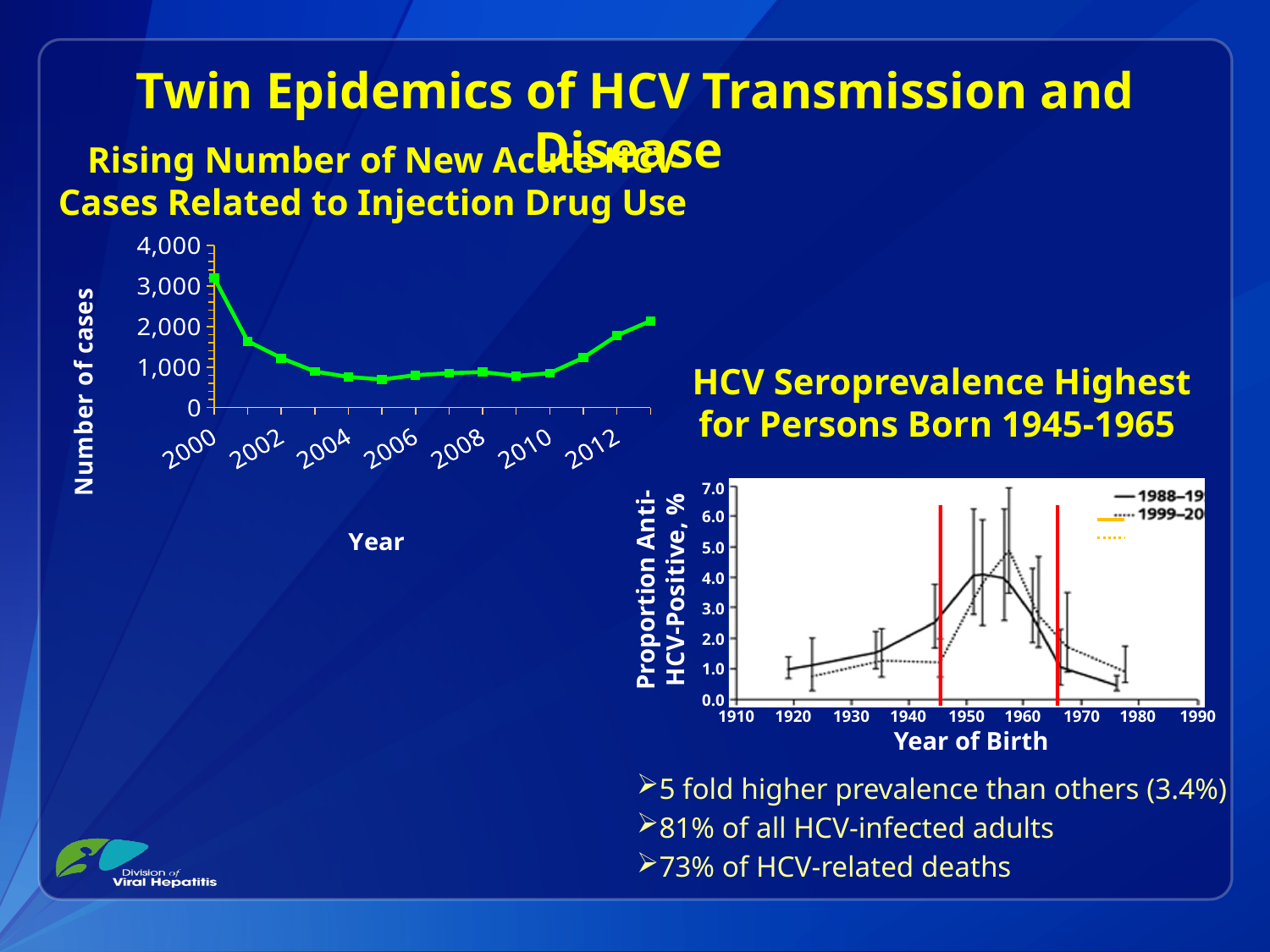
What type of chart is the left chart, 'Rising Number of New Acute HCV Cases Related to Injection Drug Use'? Line chart In the left chart of new acute HCV cases, is the value for 2005 greater or less than 1,000? less In the right chart of HCV seroprevalence, is the value of the solid (1988-19..) series for persons born around 1920 greater or less than 2.0? less In the left chart of new acute HCV cases, how do the values change from 2009 to 2013? They rise What is the x-axis label of the left chart of new acute HCV cases? Year In the left chart of new acute HCV cases, which year has the highest number of cases? 2000 In the left chart of new acute HCV cases, is the value for 2000 greater or less than 2,000? greater How many series does the legend list in the right chart, 'HCV Seroprevalence Highest for Persons Born 1945-1965'? 2 In the left chart of new acute HCV cases, which is larger, the value for 2000 or the value for 2013? 2000 What is the x-axis label of the right chart, 'HCV Seroprevalence Highest for Persons Born 1945-1965'? Year of Birth